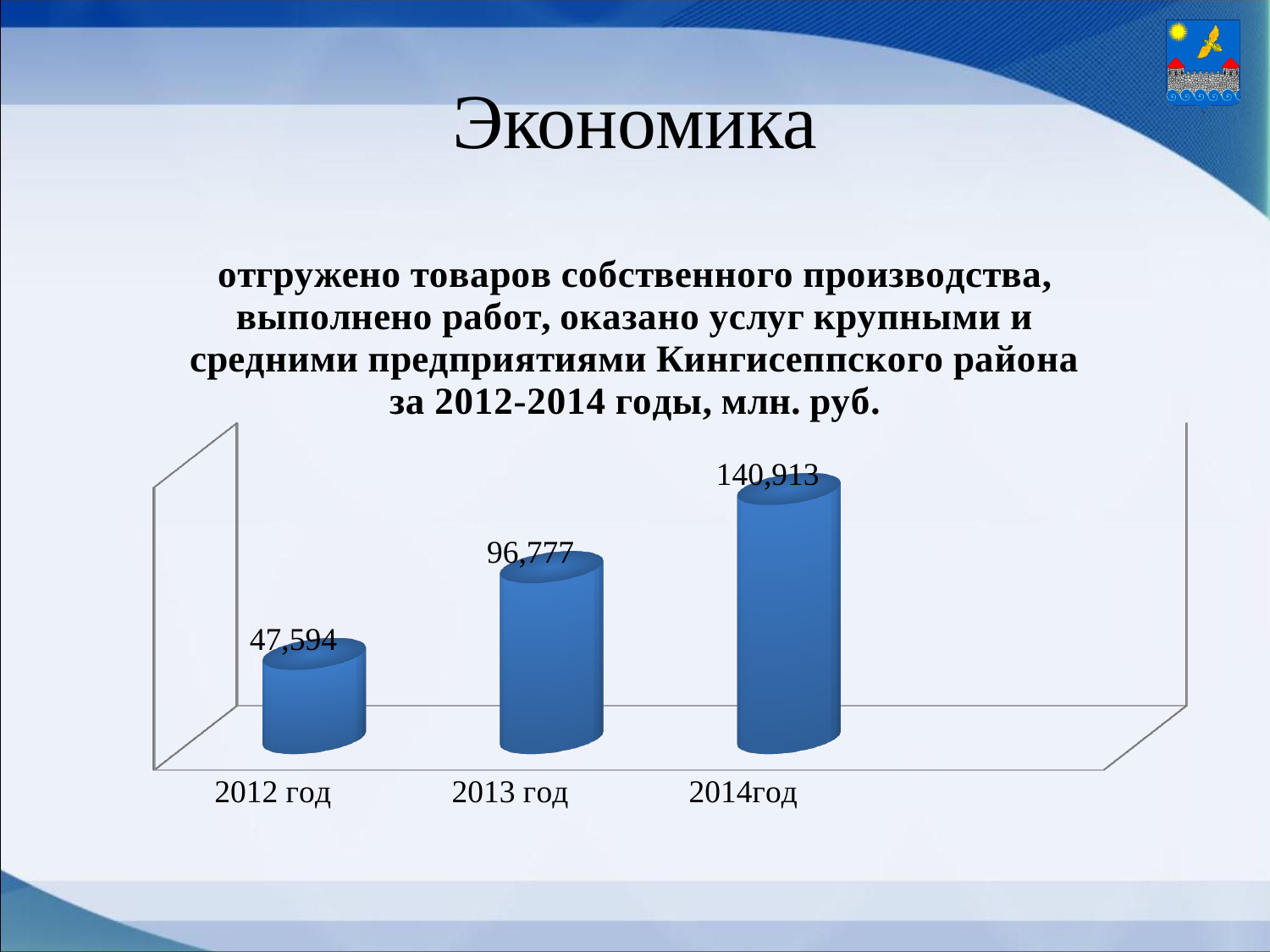
Which year has the highest value? 2014год How many years are shown on the chart? 3 What is the difference between the values for 2014год and 2013 год? 44,136 What kind of chart is shown on the slide? Bar chart What is the difference between the values for 2013 год and 2012 год? 49,183 What value is shown for 2013 год? 96,777 Which is larger, the value for 2012 год or the value for 2013 год? 2013 год What value is shown for 2014год? 140,913 What value is shown for 2012 год? 47,594 In what units are the chart values given, according to the chart title? млн. руб. Do the values rise or fall from 2012 год to 2014год? Rise Which year has the lowest value? 2012 год